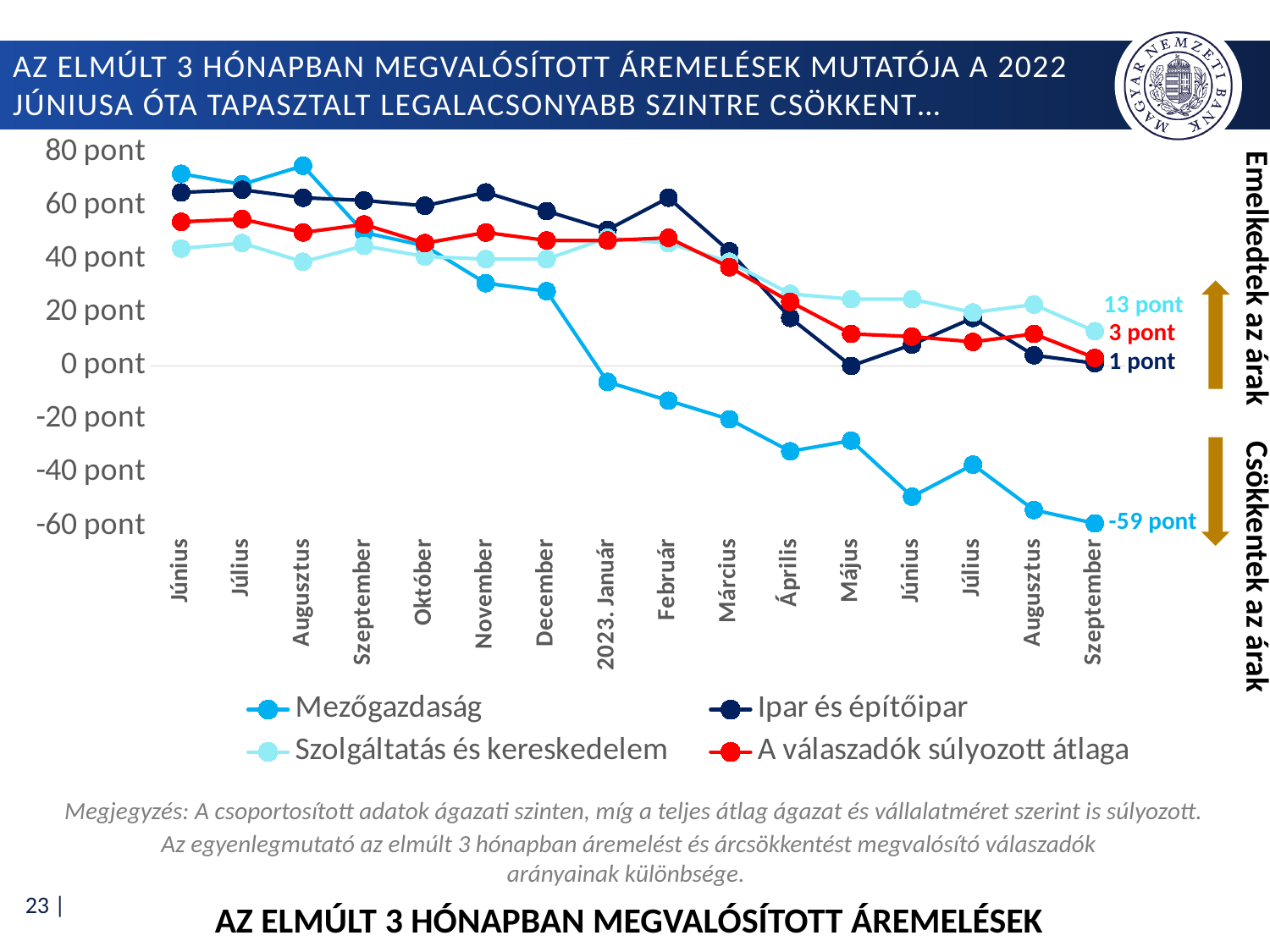
Which series has the lowest value in Szeptember 2023? Mezőgazdaság What kind of chart is shown on the slide? line chart How many series does the legend list? 4 How many months are plotted along the x axis? 16 Does the Mezőgazdaság series rise or fall from Június 2022 to Szeptember 2023? fall What is the value for Szolgáltatás és kereskedelem in Szeptember 2023? 13 pont Is the value for Mezőgazdaság in Június 2022 greater or less than 60 pont? greater In Szeptember 2023, which is larger: Szolgáltatás és kereskedelem or Ipar és építőipar? Szolgáltatás és kereskedelem What is the value for Mezőgazdaság in Szeptember 2023? -59 pont What is the value for Ipar és építőipar in Szeptember 2023? 1 pont What is the value for A válaszadók súlyozott átlaga in Szeptember 2023? 3 pont What is the difference between Szolgáltatás és kereskedelem and Mezőgazdaság in Szeptember 2023? 72 pont